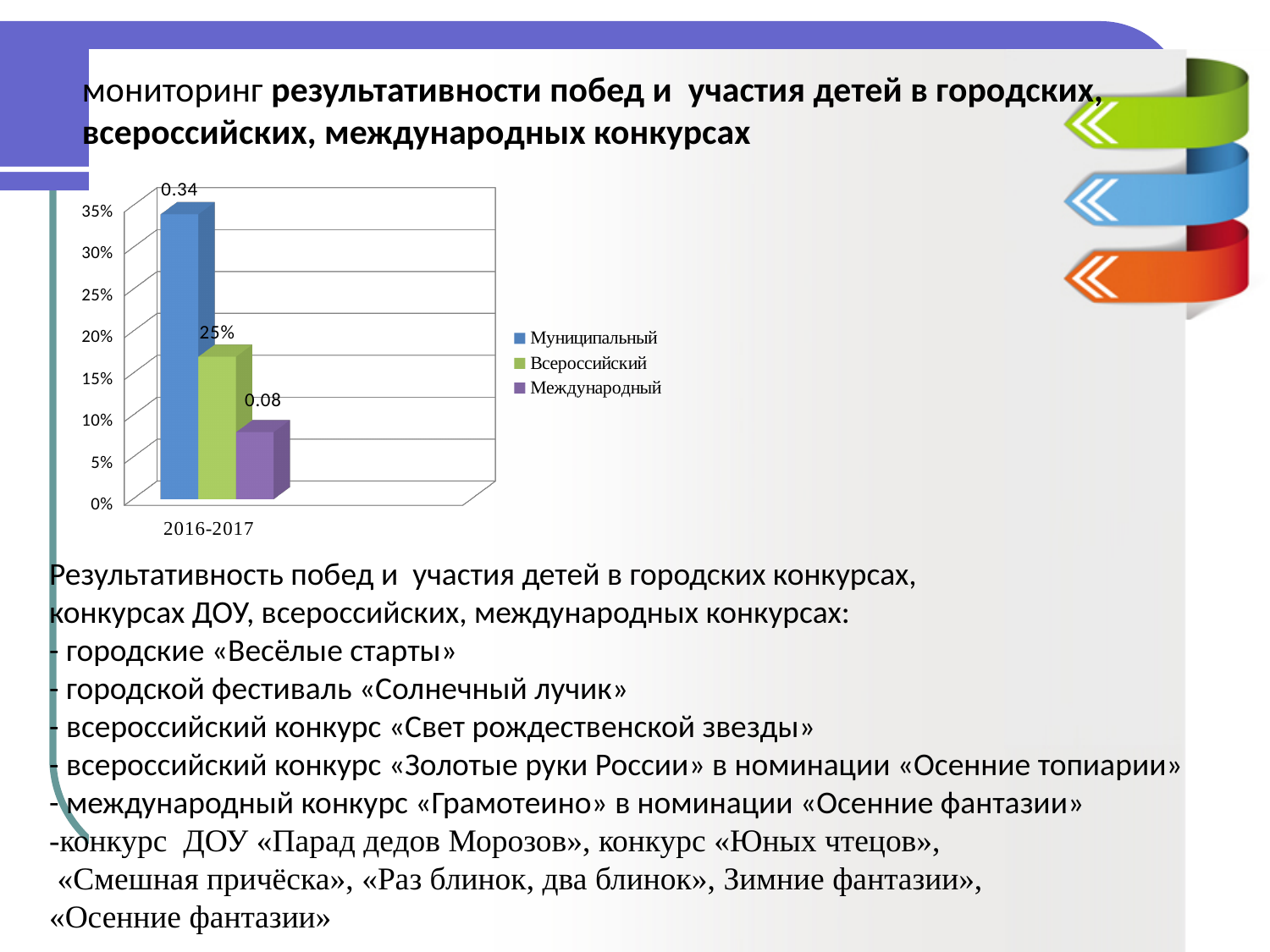
Is the value for Международный greater or less than 10%? less What kind of chart is shown on the slide? bar chart How many series does the legend list? 3 What colour represents the Всероссийский series in the legend? green Which series has the highest value in 2016-2017? Муниципальный What value is shown for the Муниципальный series in 2016-2017? 0.34 What value is shown for the Международный series in 2016-2017? 0.08 Which is larger, the value for Всероссийский or the value for Международный? Всероссийский How many categories are shown on the x axis? 1 Which series has the lowest value in 2016-2017? Международный What is the difference between the Муниципальный value (0.34) and the Международный value (0.08)? 0.26